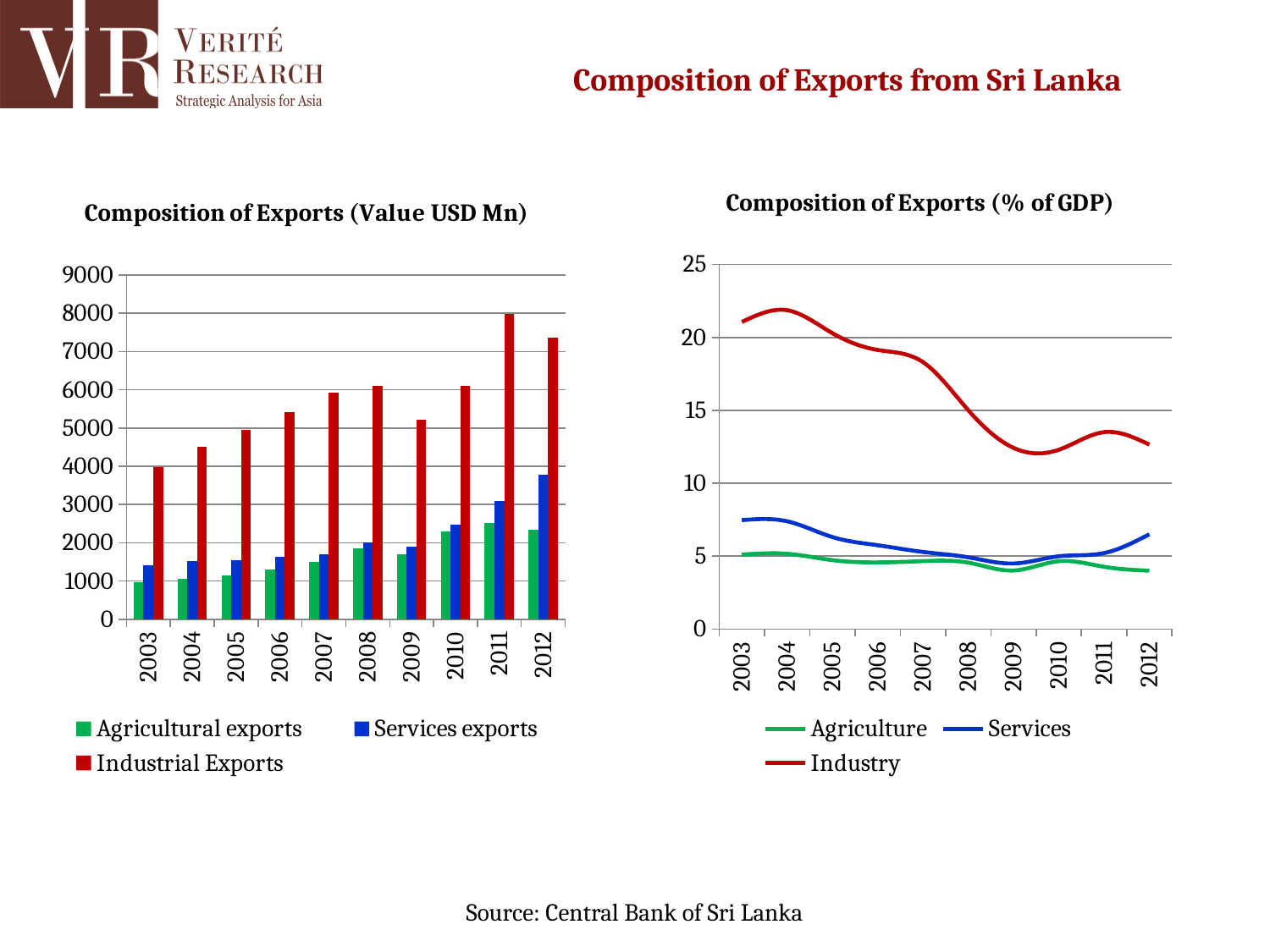
In the 'Composition of Exports (Value USD Mn)' chart, is the value for Industrial Exports in 2011 greater or less than 7000? greater In the 'Composition of Exports (Value USD Mn)' chart, is the value for Services exports in 2012 greater or less than 3000? greater In the 'Composition of Exports (Value USD Mn)' chart, in which year are Industrial Exports lowest? 2003 In the 'Composition of Exports (Value USD Mn)' chart, are Industrial Exports larger in 2008 or in 2009? 2008 In the 'Composition of Exports (Value USD Mn)' chart, in which year are Industrial Exports highest? 2011 What type of chart is the 'Composition of Exports (% of GDP)' chart on the right? line chart In the 'Composition of Exports (% of GDP)' chart, does the Industry line generally rise or fall from 2003 to 2012? fall In the 'Composition of Exports (% of GDP)' chart, is the value for Industry in 2009 greater or less than 15? less What type of chart is the 'Composition of Exports (Value USD Mn)' chart on the left? bar chart In the 'Composition of Exports (% of GDP)' chart, which series is shown in red? Industry How many series does the legend of the 'Composition of Exports (Value USD Mn)' chart list? 3 How many years are shown on the x axis of the 'Composition of Exports (% of GDP)' chart? 10